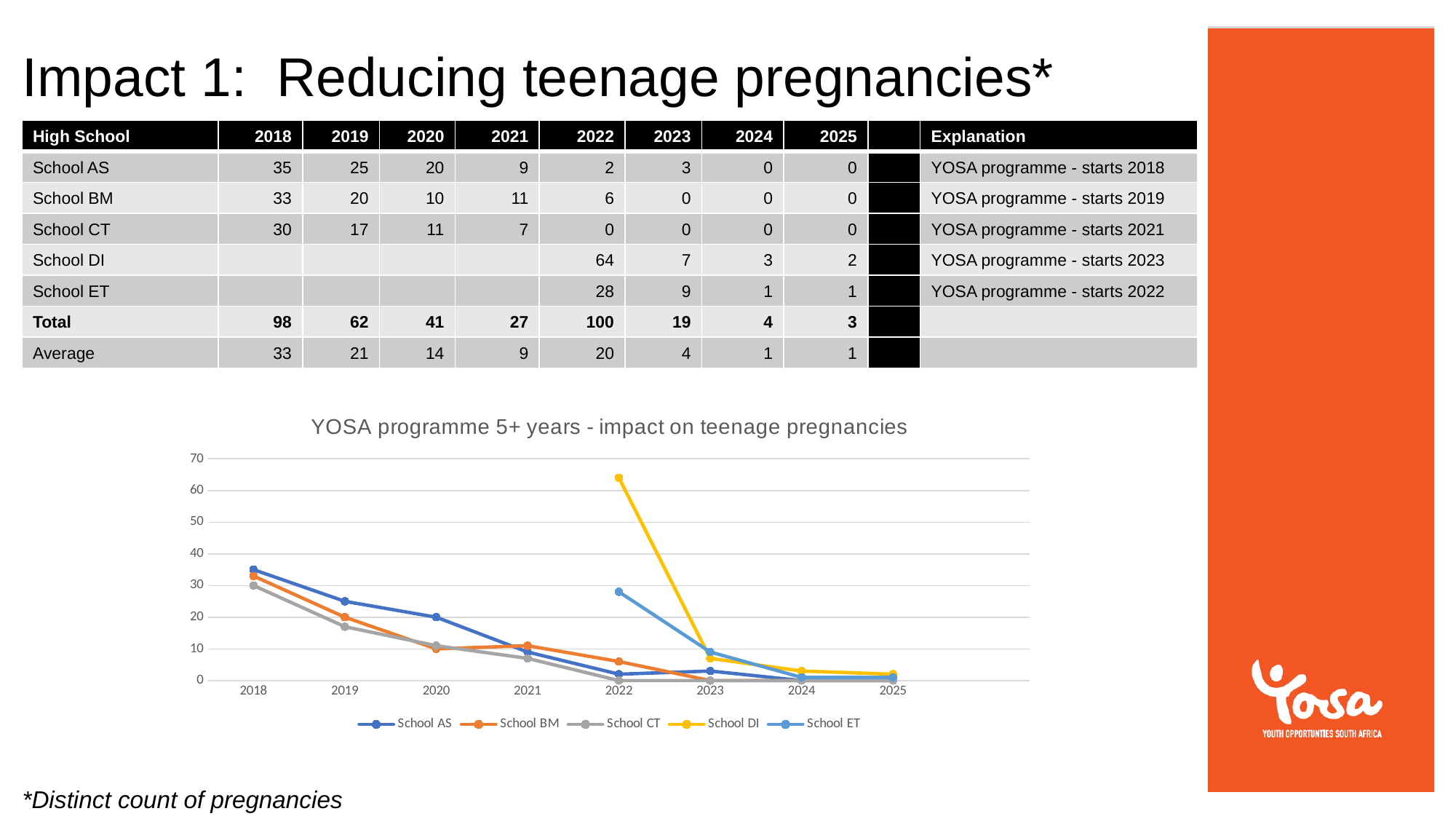
Does the value for School AS rise or fall from 2018 to 2021? fall Which school has the highest value in 2022? School DI How many series does the chart legend list? 5 What kind of chart is shown on the slide? line chart How many years are shown along the x axis of the chart? 8 Which is larger in 2019, the value for School AS or the value for School CT? School AS Is the value for School DI in 2022 greater or less than 60? greater What is the title of the chart? YOSA programme 5+ years - impact on teenage pregnancies What is the value for School AS in 2018? 35 What is the value for School DI in 2022? 64 Is the value for School ET in 2022 greater or less than 20? greater What is the difference between the value for School DI in 2022 and its value in 2023? 57